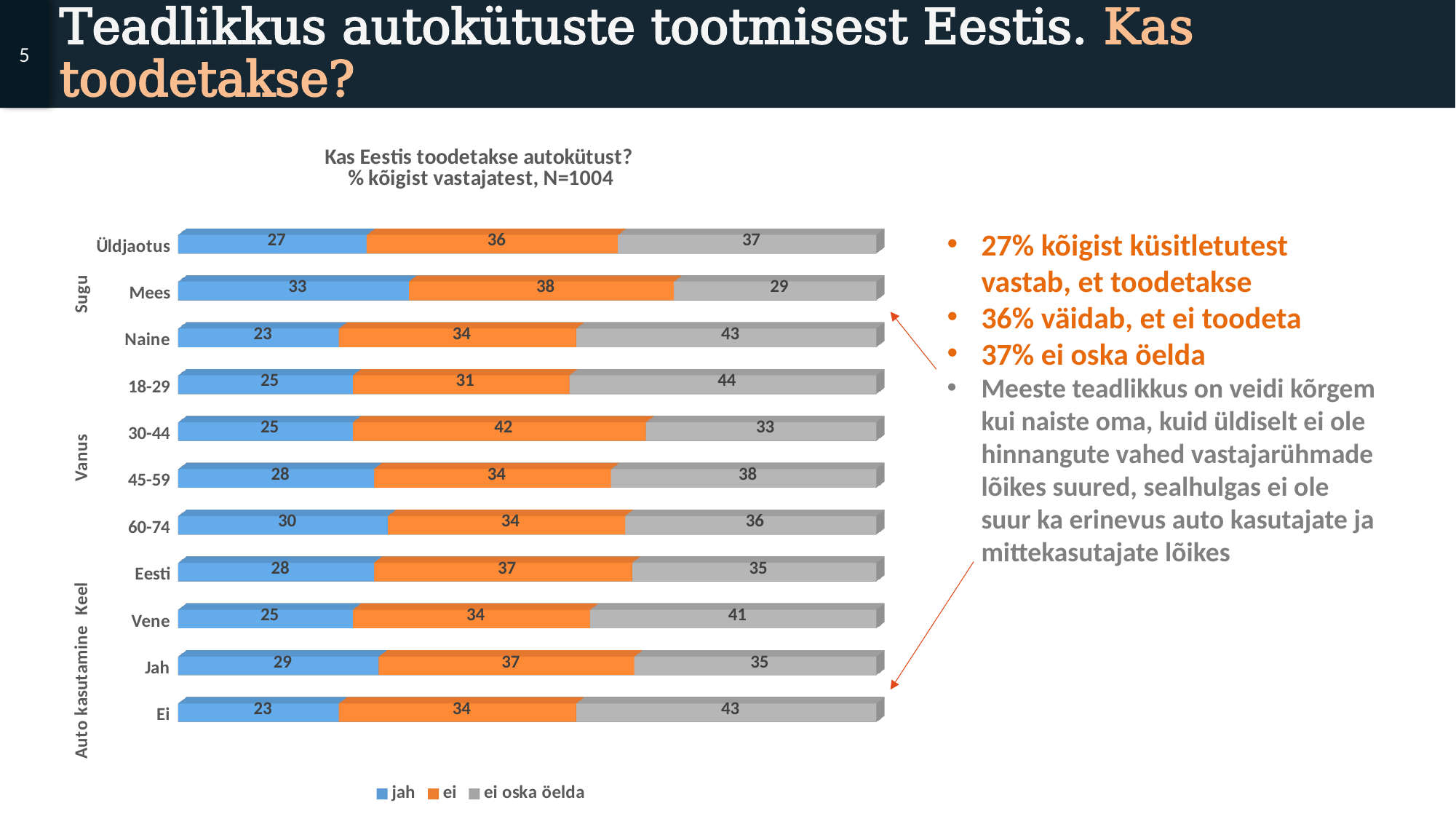
Which category has the highest "jah" value? Mees What type of chart is shown on the slide? stacked bar chart Which category has the lowest "ei" value? 18-29 What is the value of "jah" for Mees? 33 How many categories are plotted on the chart? 11 What is the difference between the "ei oska öelda" values for Naine and Mees? 14 How many series does the legend list? 3 Which is larger, the "jah" value for 60-74 or for Vene? 60-74 What is the title of the chart? Kas Eestis toodetakse autokütust? % kõigist vastajatest, N=1004 What is the value of "ei" for 30-44? 42 What is the value of "ei oska öelda" for 18-29? 44 What is the total of the stacked bar for Jah? 101